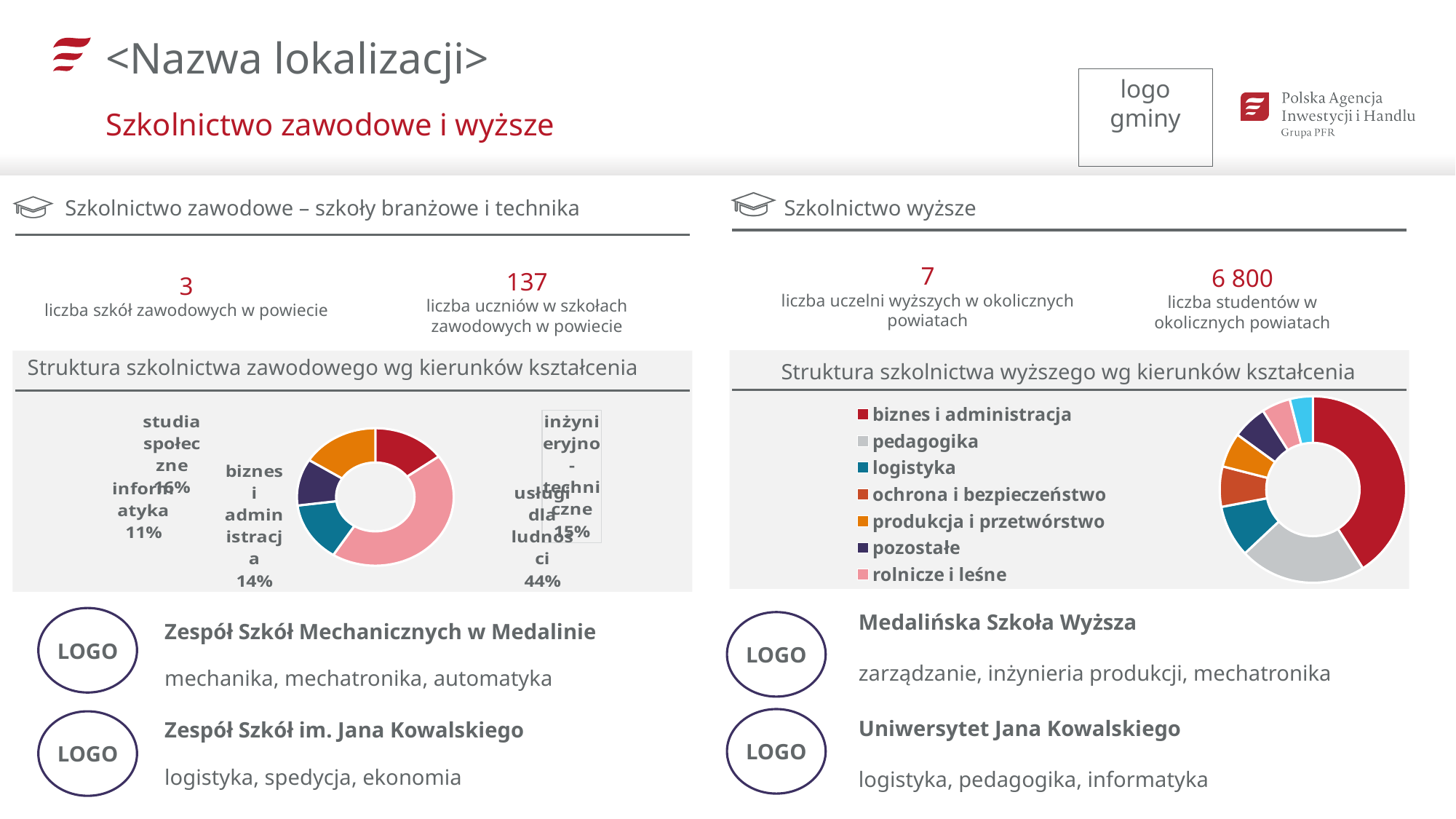
In the chart 'Struktura szkolnictwa zawodowego wg kierunków kształcenia', what is the difference in percentage points between 'studia społeczne' and 'informatyka'? 5 How many categories are shown in the chart 'Struktura szkolnictwa zawodowego wg kierunków kształcenia'? 5 In the chart 'Struktura szkolnictwa zawodowego wg kierunków kształcenia', what is the share for 'studia społeczne'? 16% In the chart 'Struktura szkolnictwa zawodowego wg kierunków kształcenia', which is larger: 'biznes i administracja' or 'inżynieryjno-techniczne'? inżynieryjno-techniczne In the chart 'Struktura szkolnictwa zawodowego wg kierunków kształcenia', which category has the smallest share? informatyka In the chart 'Struktura szkolnictwa zawodowego wg kierunków kształcenia', what is the share for 'usługi dla ludności'? 44% In the chart 'Struktura szkolnictwa wyższego wg kierunków kształcenia', what colour is the 'pedagogika' slice? grey What kind of chart is used for 'Struktura szkolnictwa zawodowego wg kierunków kształcenia'? doughnut chart How many entries does the legend of the chart 'Struktura szkolnictwa wyższego wg kierunków kształcenia' list? 7 In the chart 'Struktura szkolnictwa wyższego wg kierunków kształcenia', which category has the largest slice? biznes i administracja In the chart 'Struktura szkolnictwa zawodowego wg kierunków kształcenia', which category has the largest share? usługi dla ludności In the chart 'Struktura szkolnictwa wyższego wg kierunków kształcenia', which slice is larger: 'pedagogika' or 'logistyka'? pedagogika